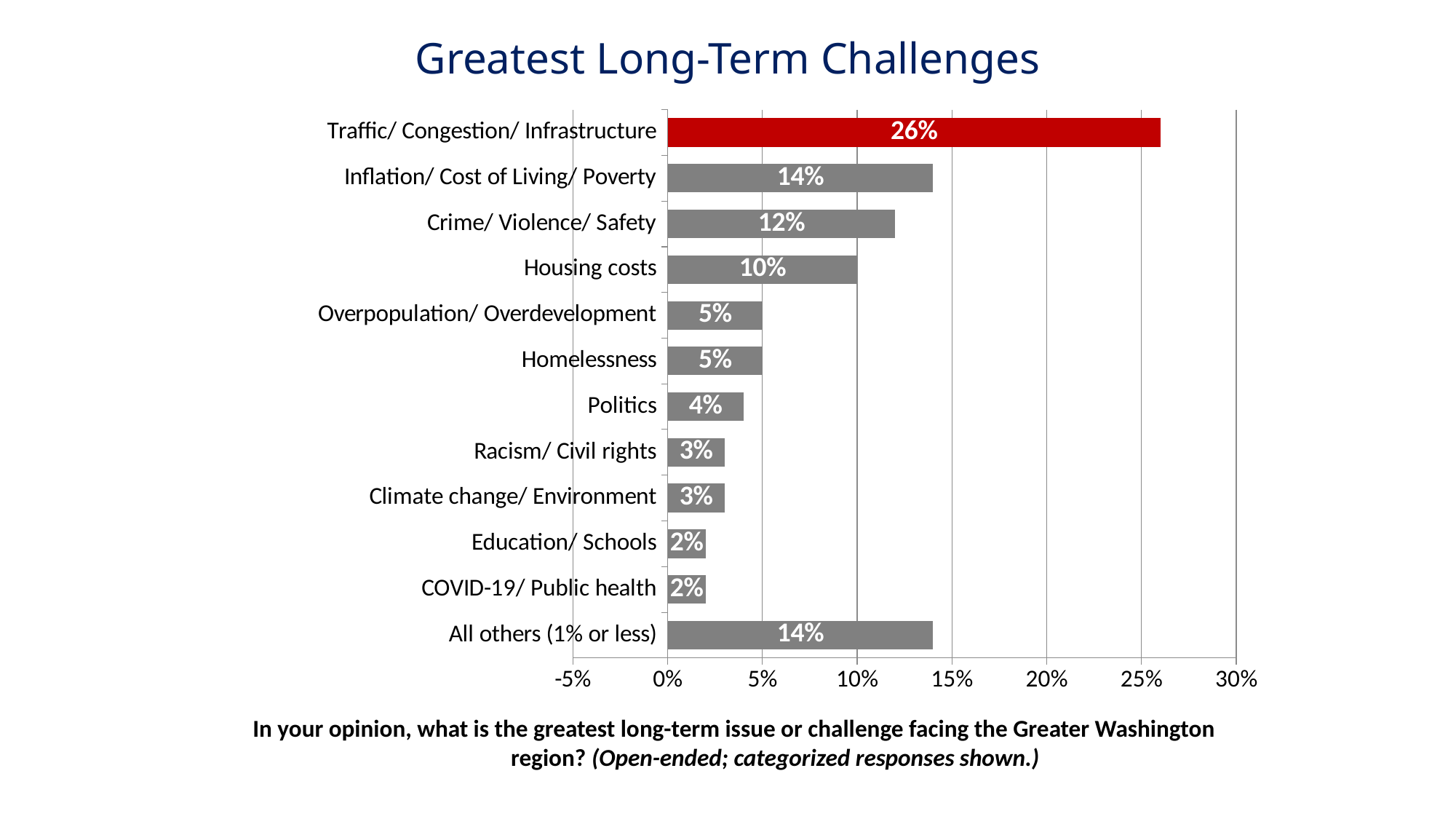
Is the value for Traffic/ Congestion/ Infrastructure greater or less than 25%? greater What kind of chart is shown on the slide? Bar chart Which is larger, the value for Politics or the value for Homelessness? Homelessness What is the difference between the values for Traffic/ Congestion/ Infrastructure and Inflation/ Cost of Living/ Poverty? 12% Which category has the highest value on the chart? Traffic/ Congestion/ Infrastructure Which bar is coloured red rather than grey? Traffic/ Congestion/ Infrastructure What percentage of respondents named Traffic/ Congestion/ Infrastructure as the greatest long-term challenge? 26% How many categories are shown on the chart? 12 What is the title of the chart? Greatest Long-Term Challenges What is the value shown for Housing costs? 10% What is the difference between the values for Crime/ Violence/ Safety and Housing costs? 2% What is the value shown for Crime/ Violence/ Safety? 12%